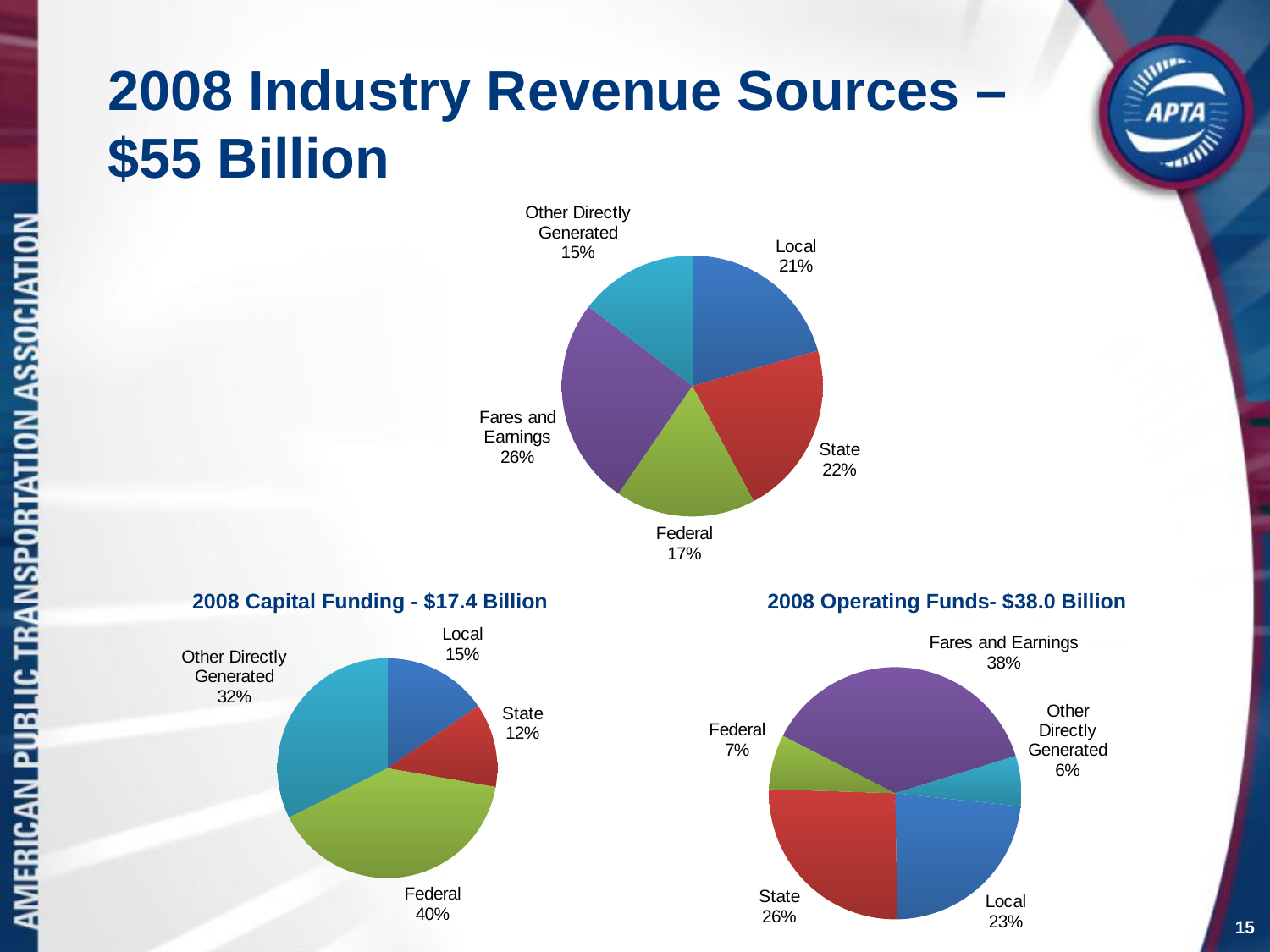
In the 2008 Capital Funding chart, which source has the largest share? Federal In the top pie chart (2008 Industry Revenue Sources), which source has the smallest share? Other Directly Generated In the top pie chart (2008 Industry Revenue Sources), what is the difference between the State and Federal shares? 5% In the top pie chart (2008 Industry Revenue Sources), what share is Fares and Earnings? 26% In the 2008 Capital Funding chart, which is larger, Local or State? Local In the 2008 Capital Funding chart, how many slices does the pie have? 4 In the 2008 Operating Funds chart, which source has the largest share? Fares and Earnings In the 2008 Capital Funding chart, what share is Federal? 40% What kind of chart is used for the 2008 Operating Funds data? Pie chart In the 2008 Operating Funds chart, what is the difference between the State and Local shares? 3% In the 2008 Operating Funds chart, what share is Other Directly Generated? 6% In the top pie chart (2008 Industry Revenue Sources), how many slices does the pie have? 5